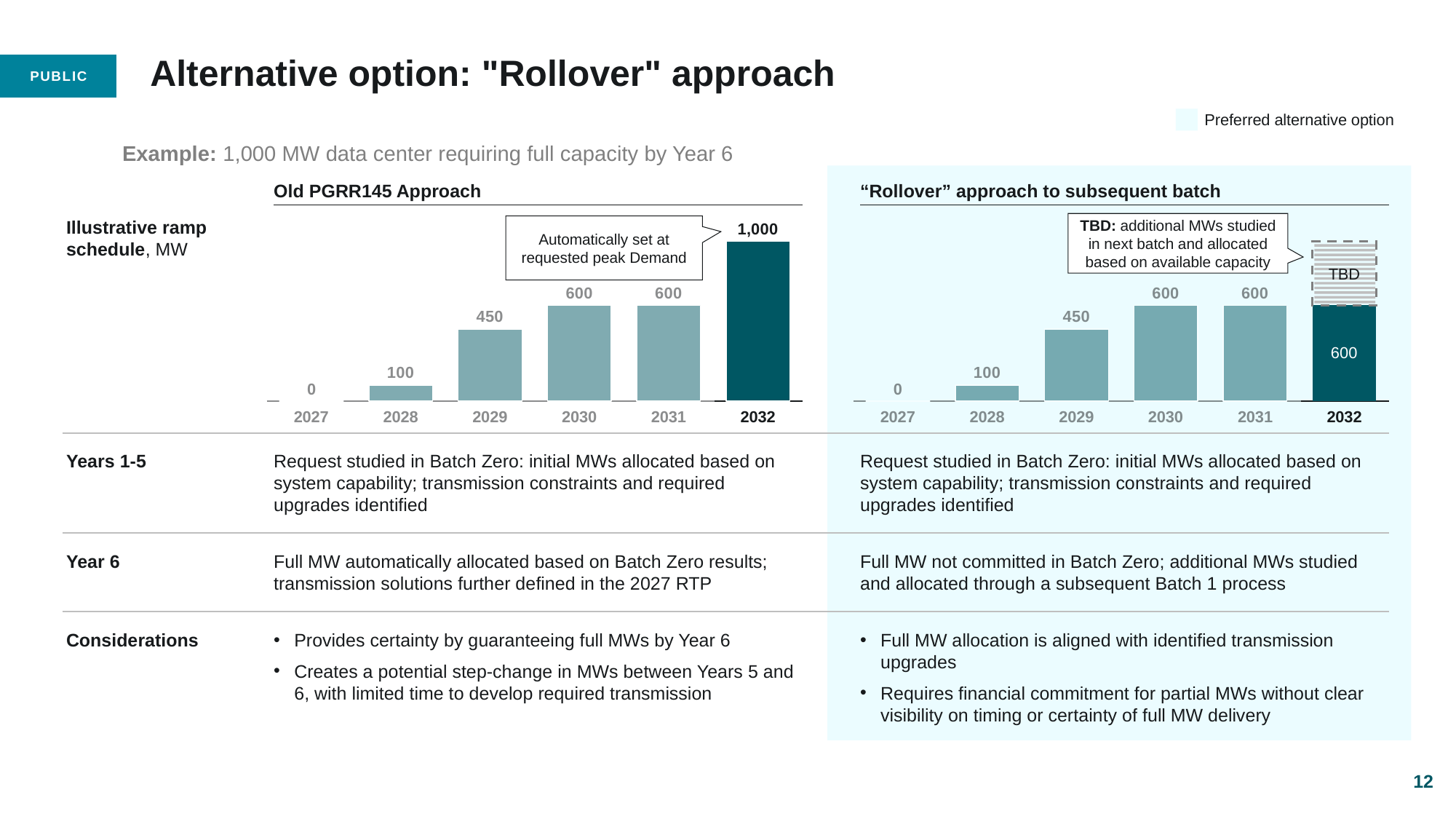
In the "Rollover" approach chart, what is the value for 2028? 100 In the "Old PGRR145 Approach" chart, what is the difference between the values for 2032 and 2031? 400 In the "Rollover" approach chart, what is the labelled value of the solid bar for 2032? 600 In the "Rollover" approach chart, what is the difference between the values for 2029 and 2028? 350 How many years are shown on the x axis of the "Old PGRR145 Approach" chart? 6 In the "Rollover" approach chart, what label is shown on the dashed segment above the 2032 bar? TBD In the "Old PGRR145 Approach" chart, what is the value for 2029? 450 In the "Old PGRR145 Approach" chart, which is larger, the value for 2029 or the value for 2030? 2030 What type of chart is the "Rollover" approach chart? Bar chart In the "Old PGRR145 Approach" chart, which year has the lowest value? 2027 In the "Old PGRR145 Approach" chart, which year has the highest value? 2032 In the "Old PGRR145 Approach" chart, what is the value for 2032? 1,000